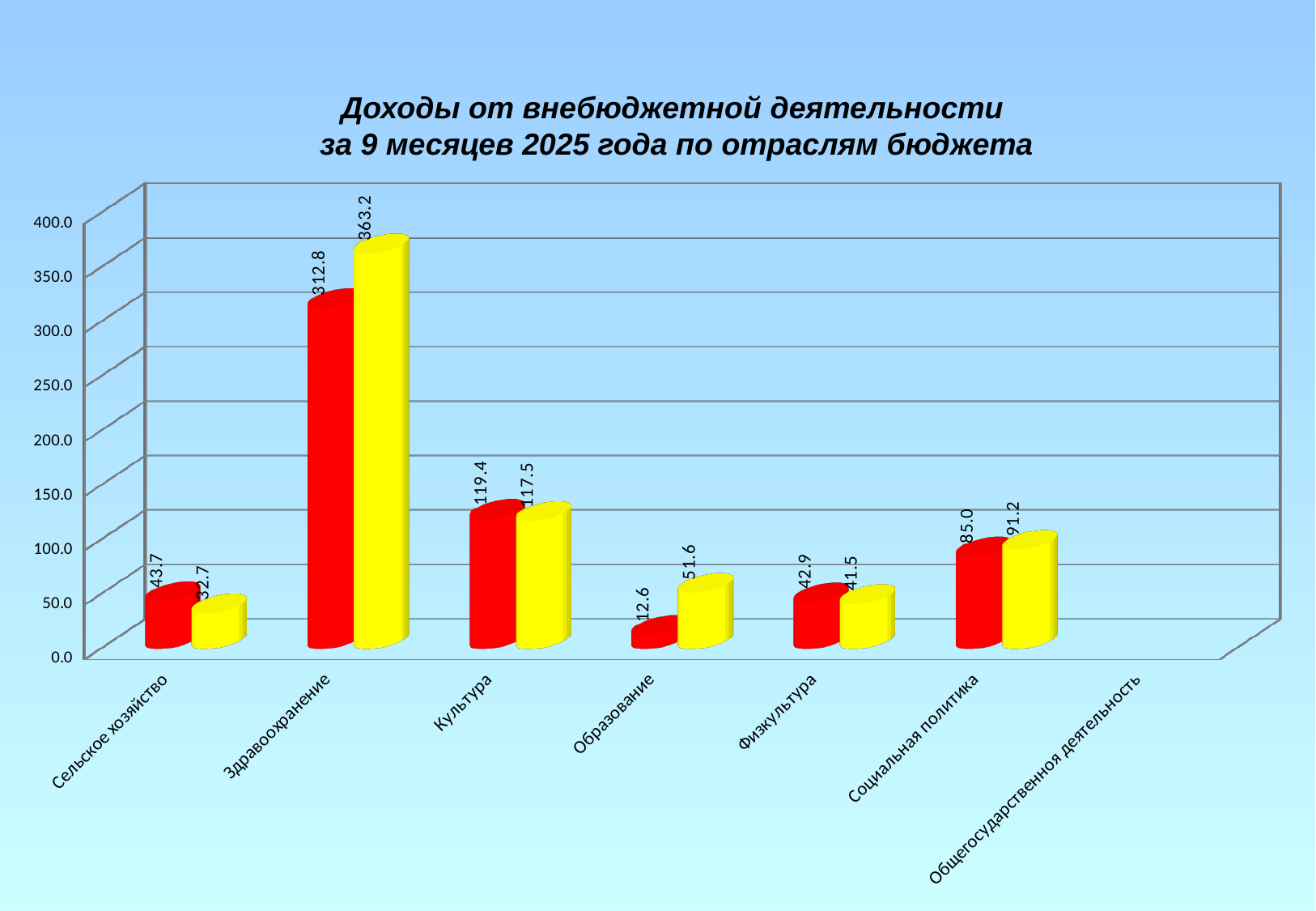
What is the difference between the red and yellow bars for Сельское хозяйство? 11.0 What is the value of the red bar for Физкультура? 42.9 What is the difference between the yellow and red bars for Здравоохранение? 50.4 How many category labels are shown on the x axis? 7 Which category has the highest yellow bar? Здравоохранение Is the value of the red bar for Культура greater or less than 100.0? greater What is the value of the red bar for Здравоохранение? 312.8 For Образование, which bar is larger, the red or the yellow? yellow What is the value of the yellow bar for Социальная политика? 91.2 Which category has the lowest red bar? Образование What type of chart is shown on the slide? bar chart What is the value of the yellow bar for Образование? 51.6